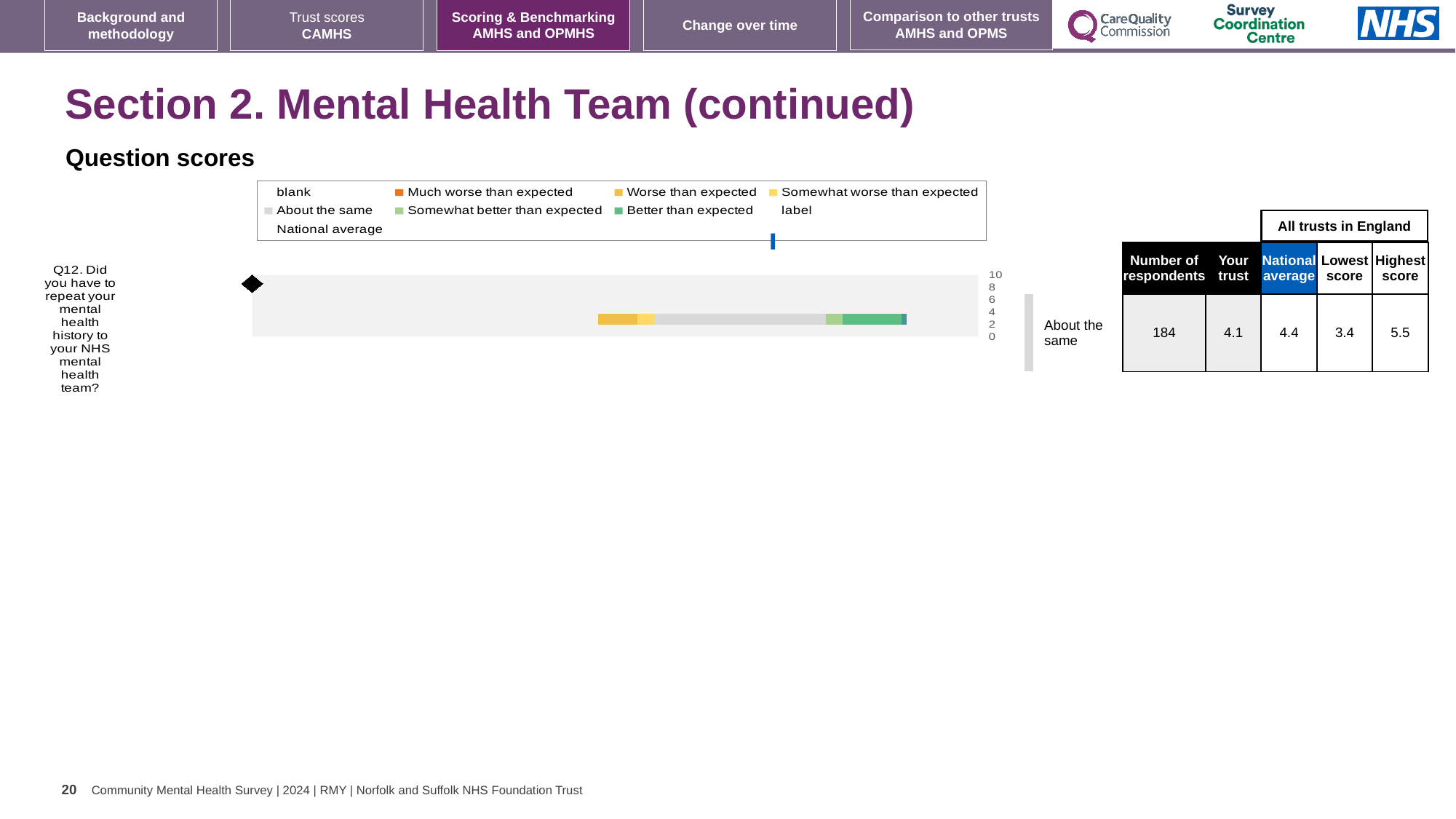
In the table beside the chart, what is the national average score for Q12? 4.4 In the table beside the chart, what is the 'Your trust' score for Q12? 4.1 How many questions are plotted in the chart? 1 For Q12, which is larger: the 'Your trust' score or the national average? National average For Q12, what is the difference between the highest score and the lowest score across all trusts in England? 2.1 In the table beside the chart, how many respondents answered Q12? 184 What benchmark category label is shown to the right of the Q12 bar? About the same What is the highest tick value shown on the chart's axis? 10 What kind of chart is used to show the Q12 question score? Bar chart How many entries does the chart legend list? 9 Which question is plotted in the chart? Q12. Did you have to repeat your mental health history to your NHS mental health team? For Q12, what is the difference between the national average and the 'Your trust' score? 0.3